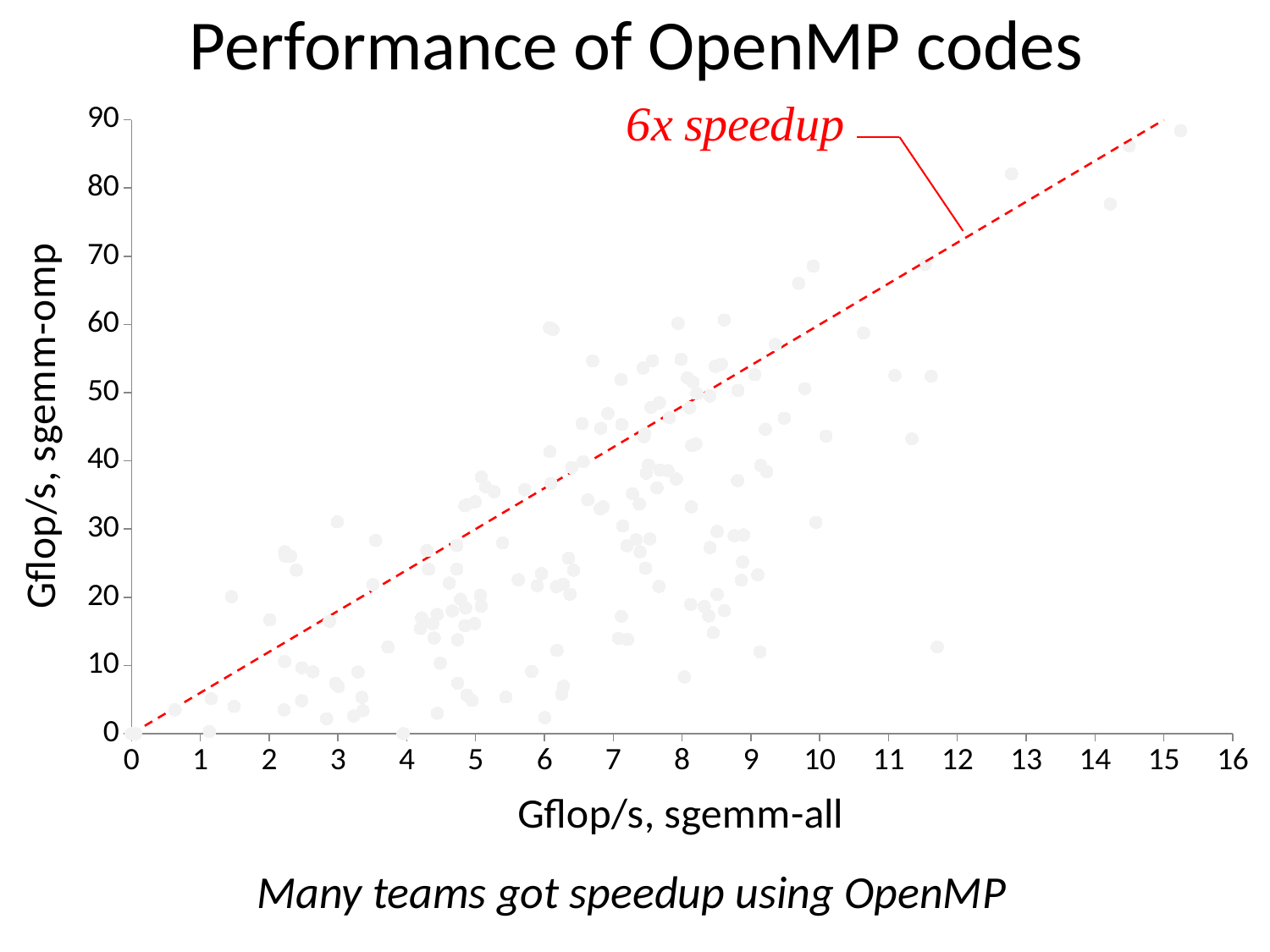
Do the sgemm-omp values generally rise or fall as the sgemm-all values increase along the x axis? rise What kind of chart is shown on the slide? scatter chart Is the sgemm-omp value of the point at about 1.4 Gflop/s sgemm-all greater or less than 30? less What does the label next to the red dashed line say? 6x speedup Is the sgemm-omp value of the rightmost point (at about 15 Gflop/s sgemm-all) greater or less than 80? greater What is the title of the chart? Performance of OpenMP codes